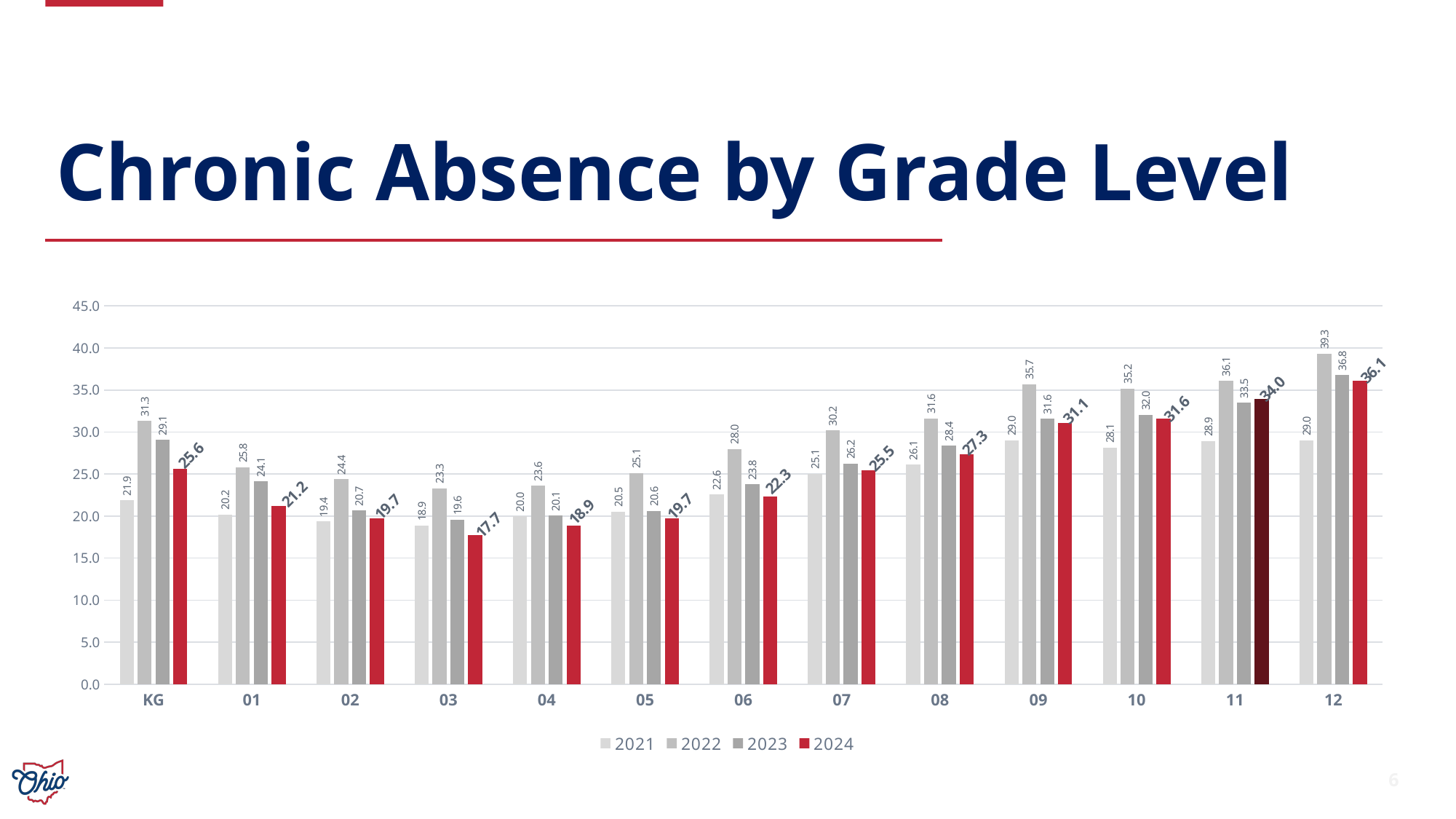
Is the 2022 value for grade 10 greater or less than 30? greater What is the difference between the 2022 and 2024 values for grade 09? 4.6 What is the 2021 value for KG? 21.9 How many series does the legend list? 4 What is the title of the chart? Chronic Absence by Grade Level How many grade-level categories are shown on the x axis? 13 For grade 11, which is larger, the 2023 value or the 2024 value? 2024 What is the 2024 chronic absence value for grade 03? 17.7 Which grade level has the highest 2024 value? 12 What is the 2022 chronic absence value for grade 12? 39.3 Which grade level has the lowest 2024 value? 03 What type of chart is shown on the slide? bar chart